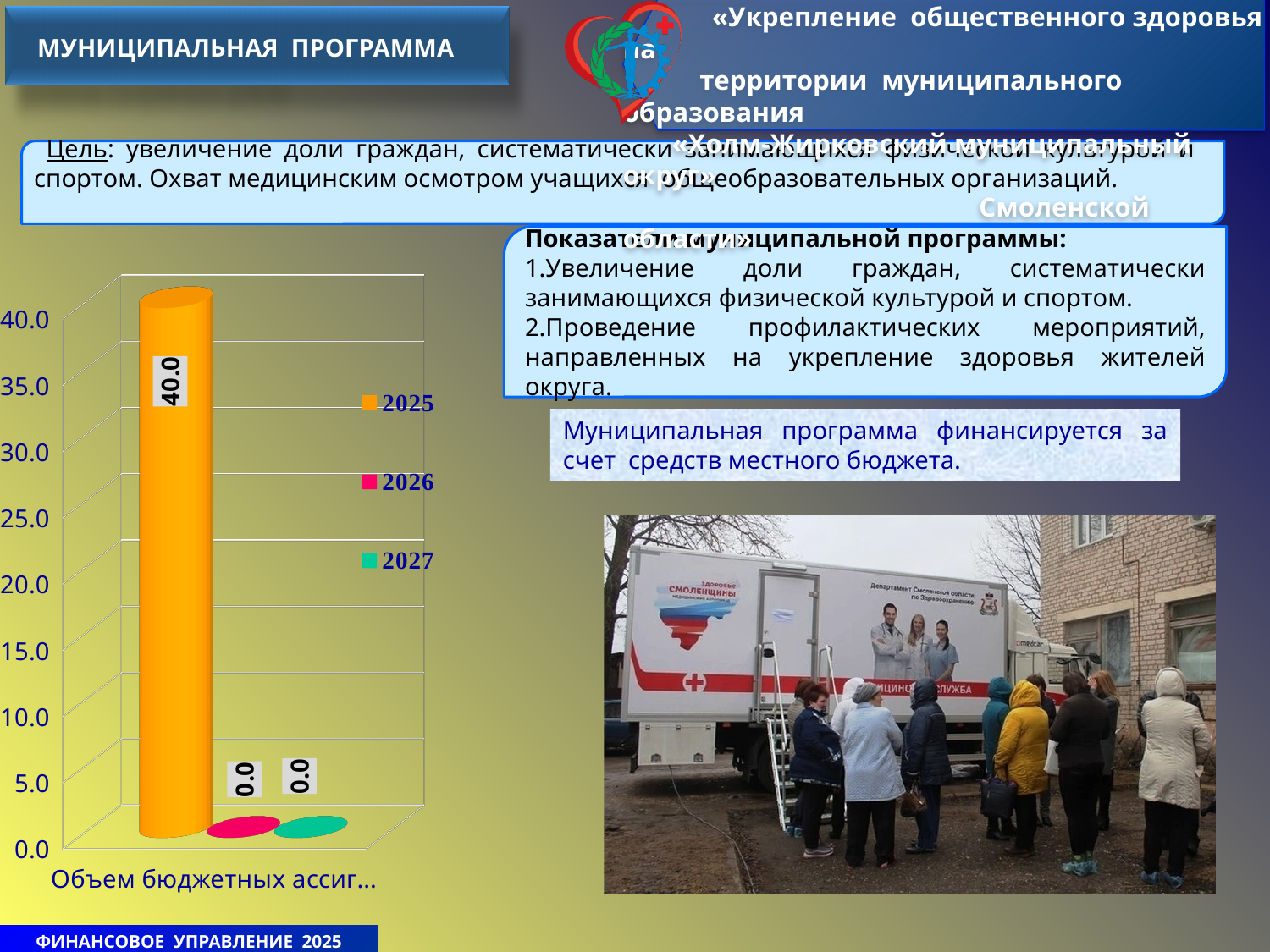
Is the value for 2025 greater or less than 35.0? greater What is the total of the values for 2025, 2026 and 2027 shown in the chart? 40.0 Which is larger, the value for 2025 or the value for 2027? 2025 What is the value for 2026 in the chart? 0.0 What is the highest value shown on the chart's vertical axis? 40.0 What kind of chart is shown on the slide? bar chart Which year has the highest value in the chart? 2025 What is the value for 2025 in the chart? 40.0 How many series does the chart legend list? 3 What colour is the bar for 2025 in the chart? orange What is the value for 2027 in the chart? 0.0 What is the difference between the values for 2025 and 2026? 40.0